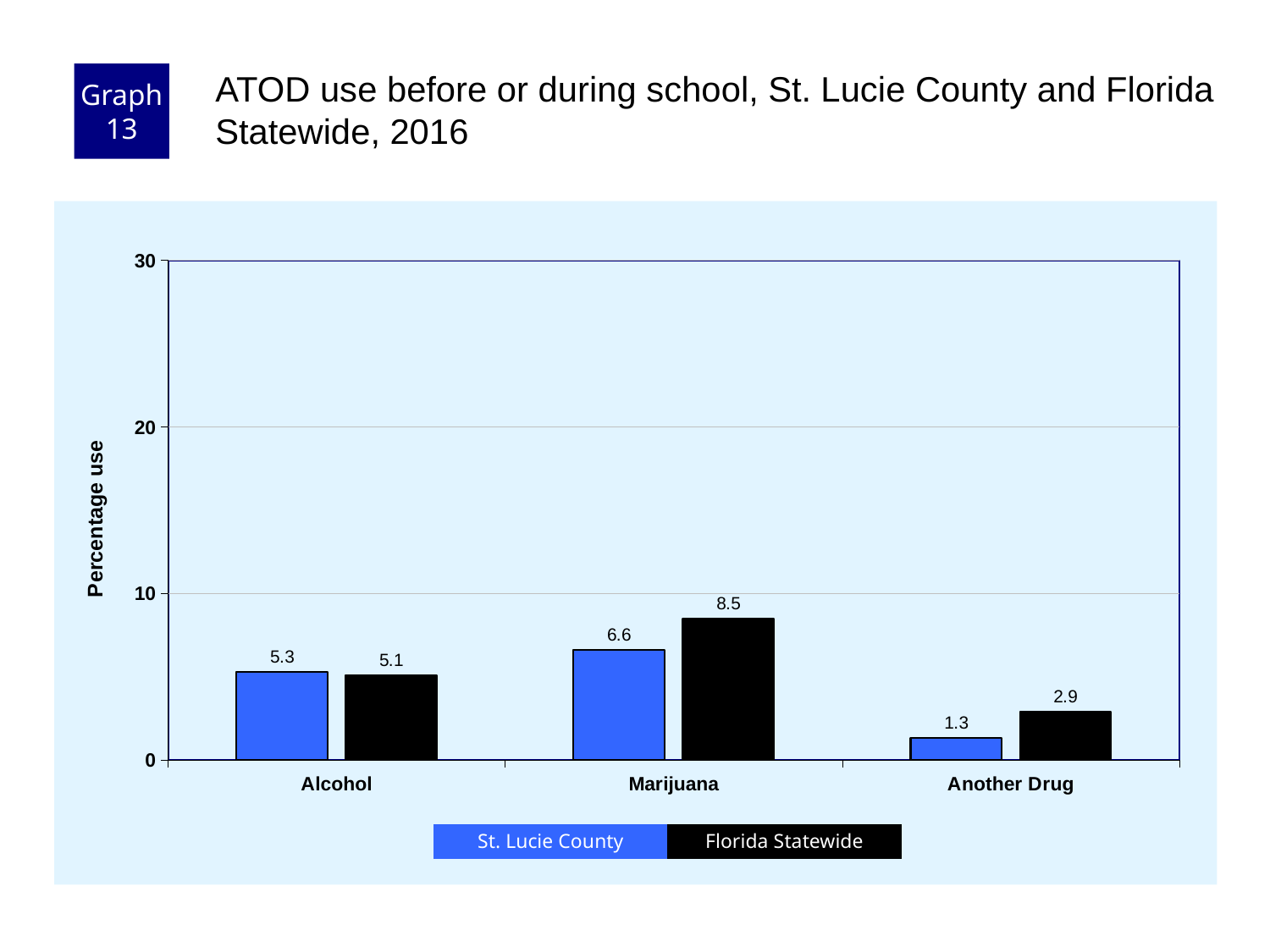
What is the St. Lucie County value for Alcohol? 5.3 What is the St. Lucie County value for Another Drug? 1.3 How many series does the legend list? 2 Is the Florida Statewide value for Marijuana greater or less than 10? less Which category has the highest St. Lucie County value? Marijuana What is the Florida Statewide value for Marijuana? 8.5 For Another Drug, which is larger: St. Lucie County or Florida Statewide? Florida Statewide What kind of chart is shown on the slide? bar chart What is the Florida Statewide value for Another Drug? 2.9 What is the difference between the Florida Statewide and St. Lucie County values for Marijuana? 1.9 Which category has the lowest Florida Statewide value? Another Drug How many categories are shown on the x axis? 3